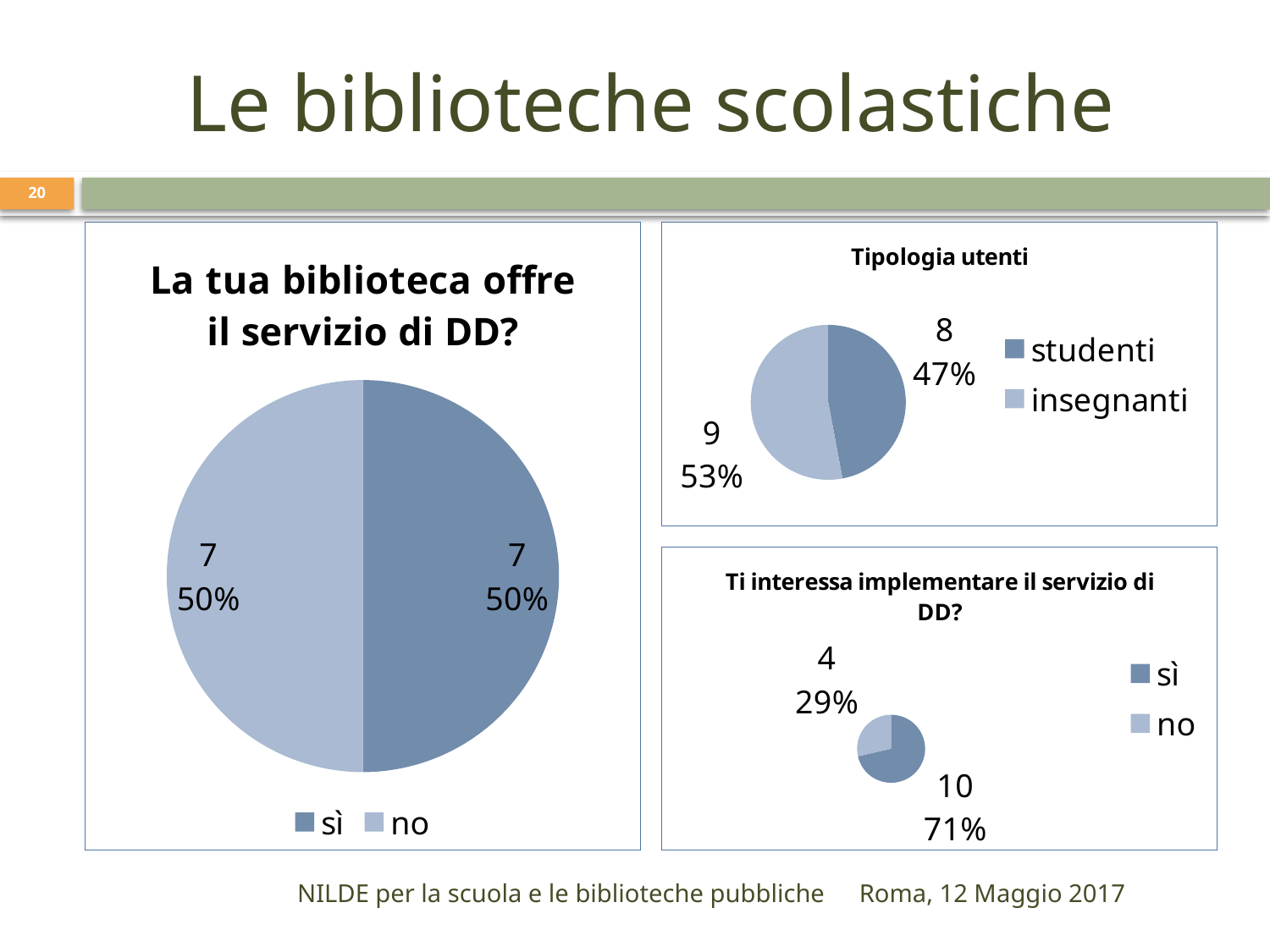
In the chart titled "Ti interessa implementare il servizio di DD?", what percentage share does the no slice have? 29% What kind of chart is the chart titled "Tipologia utenti"? pie chart How many categories does the chart titled "La tua biblioteca offre il servizio di DD?" show? 2 In the chart titled "La tua biblioteca offre il servizio di DD?", what percentage share does the sì slice have? 50% In the chart titled "Ti interessa implementare il servizio di DD?", which category is the smallest? no In the chart titled "Tipologia utenti", how many users are studenti? 8 In the chart titled "Ti interessa implementare il servizio di DD?", what is the difference between the number of sì and no answers? 6 In the chart titled "Tipologia utenti", which category is the largest? insegnanti In the chart titled "Ti interessa implementare il servizio di DD?", how many respondents answered sì? 10 In the chart titled "Tipologia utenti", what are the two legend entries? studenti, insegnanti In the chart titled "Tipologia utenti", what percentage share do insegnanti have? 53% In the chart titled "La tua biblioteca offre il servizio di DD?", how many respondents answered no? 7